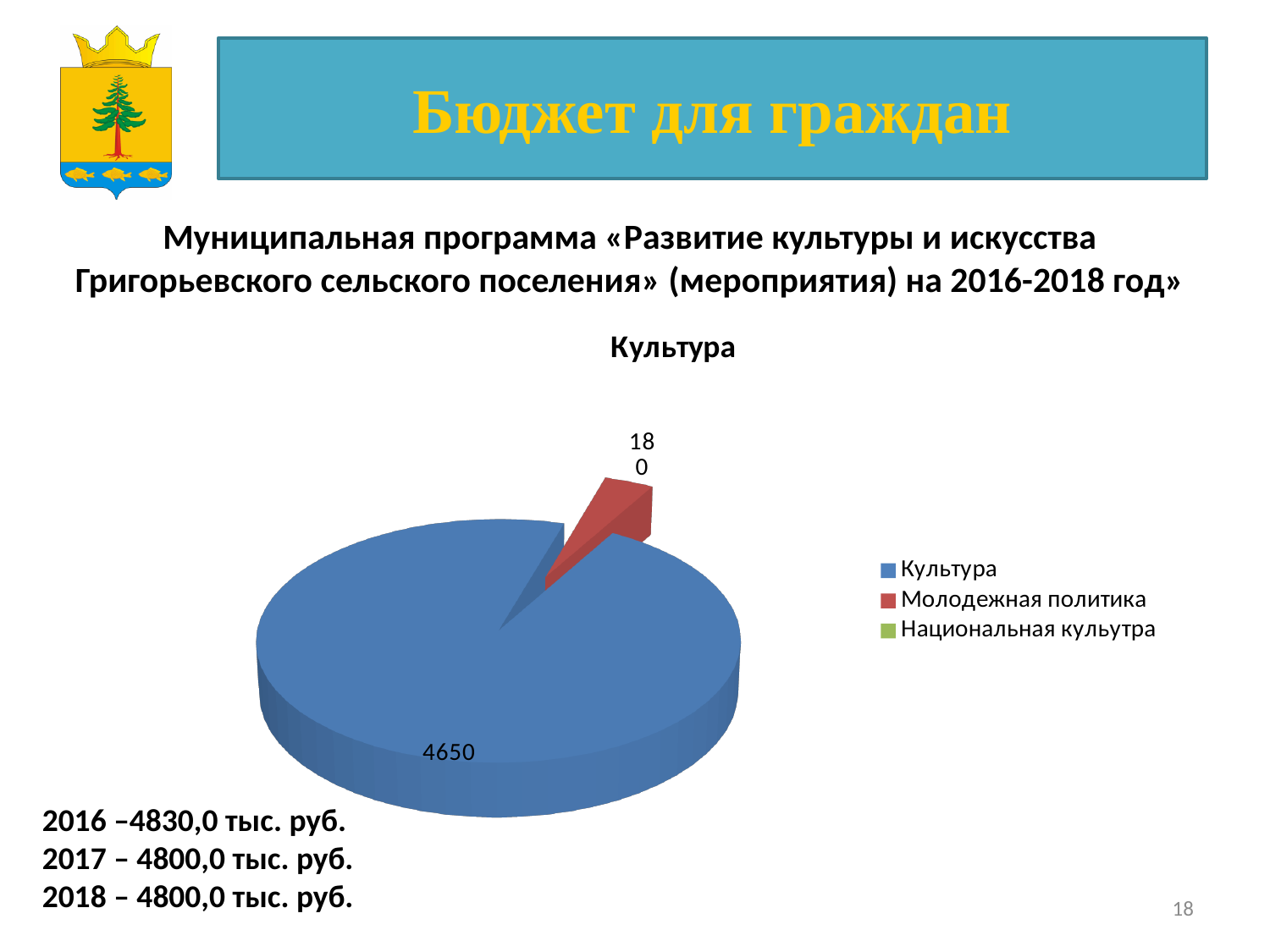
What kind of chart is shown on the slide? pie chart What is the value for Национальная кульутра? 0 What colour is the slice for Молодежная политика? red What is the value for Культура? 4650 How many entries does the legend list? 3 What is the value for Молодежная политика? 180 Which category has the largest slice? Культура Which category has the smallest value? Национальная кульутра What is the chart's title? Культура What is the total of all the values shown in the pie chart? 4830 Which is larger, the value for Молодежная политика or the value for Национальная кульутра? Молодежная политика What is the difference between the values for Культура and Молодежная политика? 4470